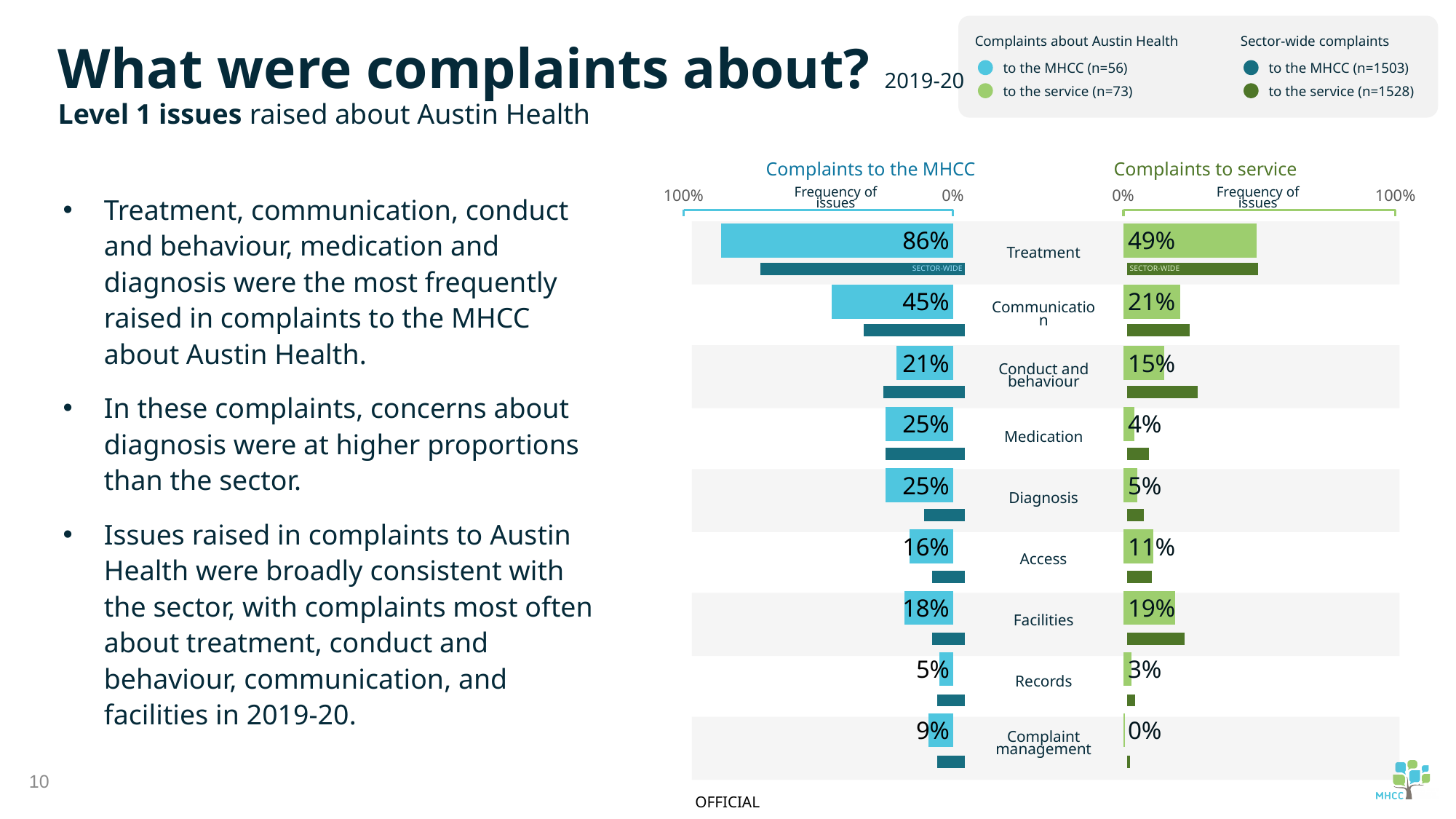
What kind of chart is shown on the slide? Bar chart In the 'Complaints to service' chart, which category has the lowest value? Complaint management In the 'Complaints to service' chart, what is the value for Facilities? 19% Which is larger: the value for Facilities in the 'Complaints to the MHCC' chart or in the 'Complaints to service' chart? Complaints to service In the 'Complaints to the MHCC' chart, what is the value for Treatment? 86% In the 'Complaints to the MHCC' chart, what is the difference between the values for Treatment and Communication? 41% How many categories are listed in the chart? 9 In the 'Complaints to the MHCC' chart, which is larger: the value for Medication or the value for Access? Medication In the 'Complaints to the MHCC' chart, which category has the highest value? Treatment How many series does the legend list? 4 In the 'Complaints to service' chart, what is the difference between the values for Treatment and Communication? 28% According to the legend, what is the sample size (n) for complaints about Austin Health to the MHCC? n=56